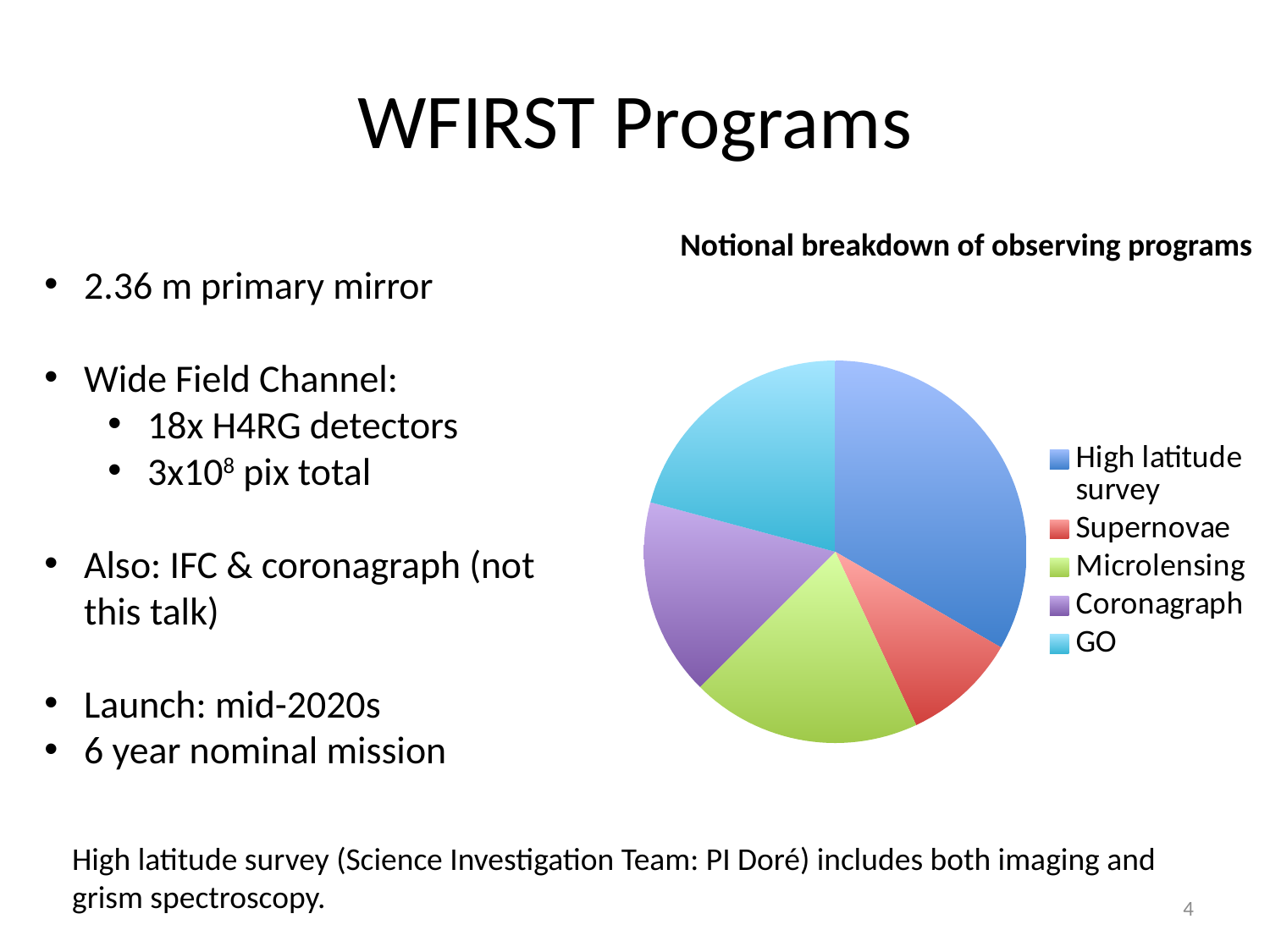
How many slices does the pie chart have? 5 Which slice is larger, Microlensing or Supernovae? Microlensing What kind of chart is shown on the slide? pie chart Which program has the smallest slice of the pie? Supernovae Which slice is larger, Coronagraph or Supernovae? Coronagraph Which slice is larger, High latitude survey or Coronagraph? High latitude survey What colour is the Microlensing slice in the pie chart? green What is the title of the chart? Notional breakdown of observing programs Which program has the largest slice of the pie? High latitude survey How many entries does the chart legend list? 5